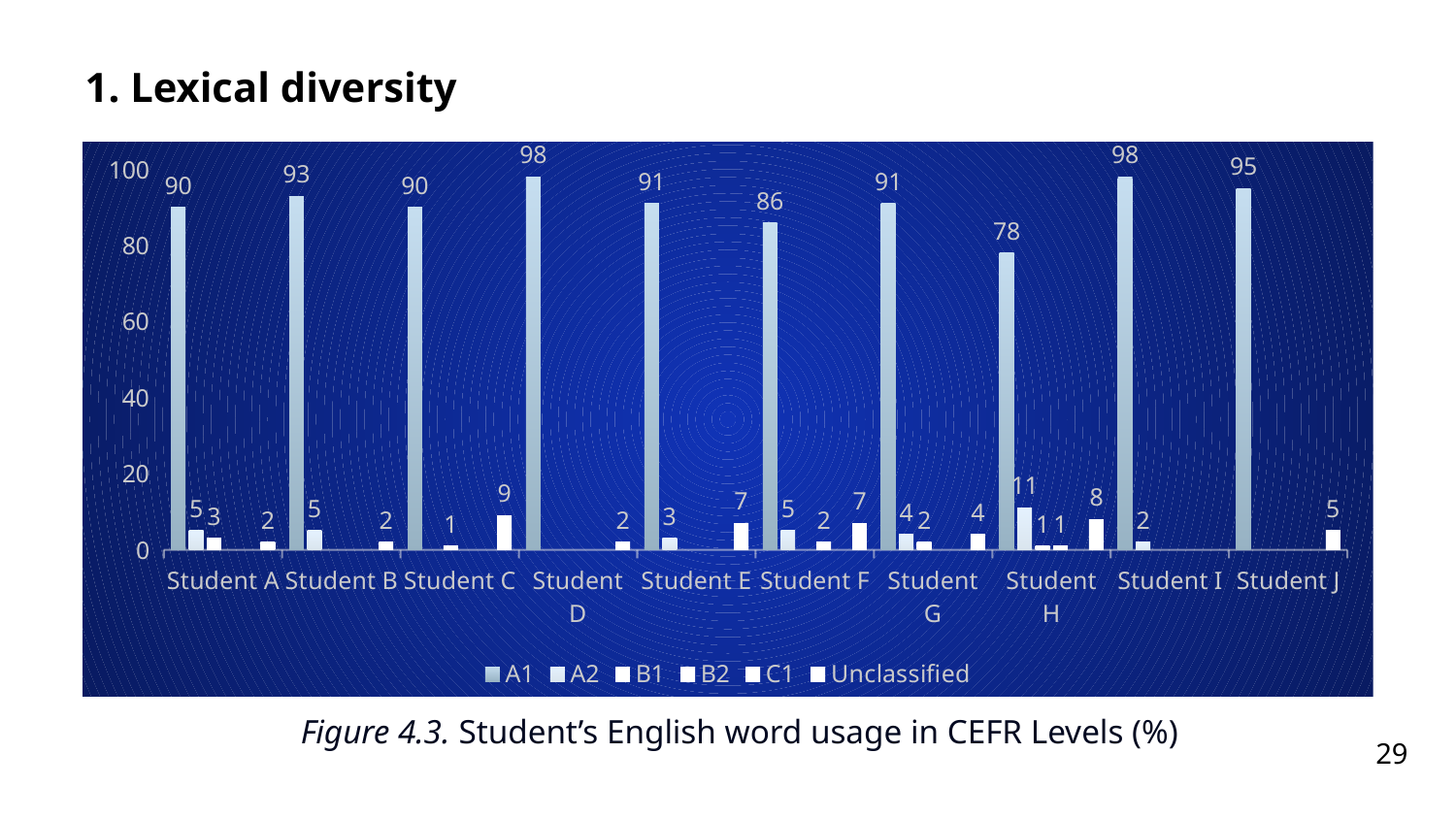
How many series does the legend list? 6 How many students are shown on the x axis? 10 What kind of chart is shown on the slide? bar chart What is the A1 value for Student F? 86 What is the last entry listed in the chart legend? Unclassified What is the A1 value for Student D? 98 Is the A1 value for Student H greater or less than 80? less What is the A1 value for Student H? 78 What is the difference between the A1 values of Student D and Student H? 20 Which student has the lowest A1 value? Student H Which is larger, the A1 value for Student B or the A1 value for Student F? Student B What is the caption of the figure below the chart? Figure 4.3. Student's English word usage in CEFR Levels (%)